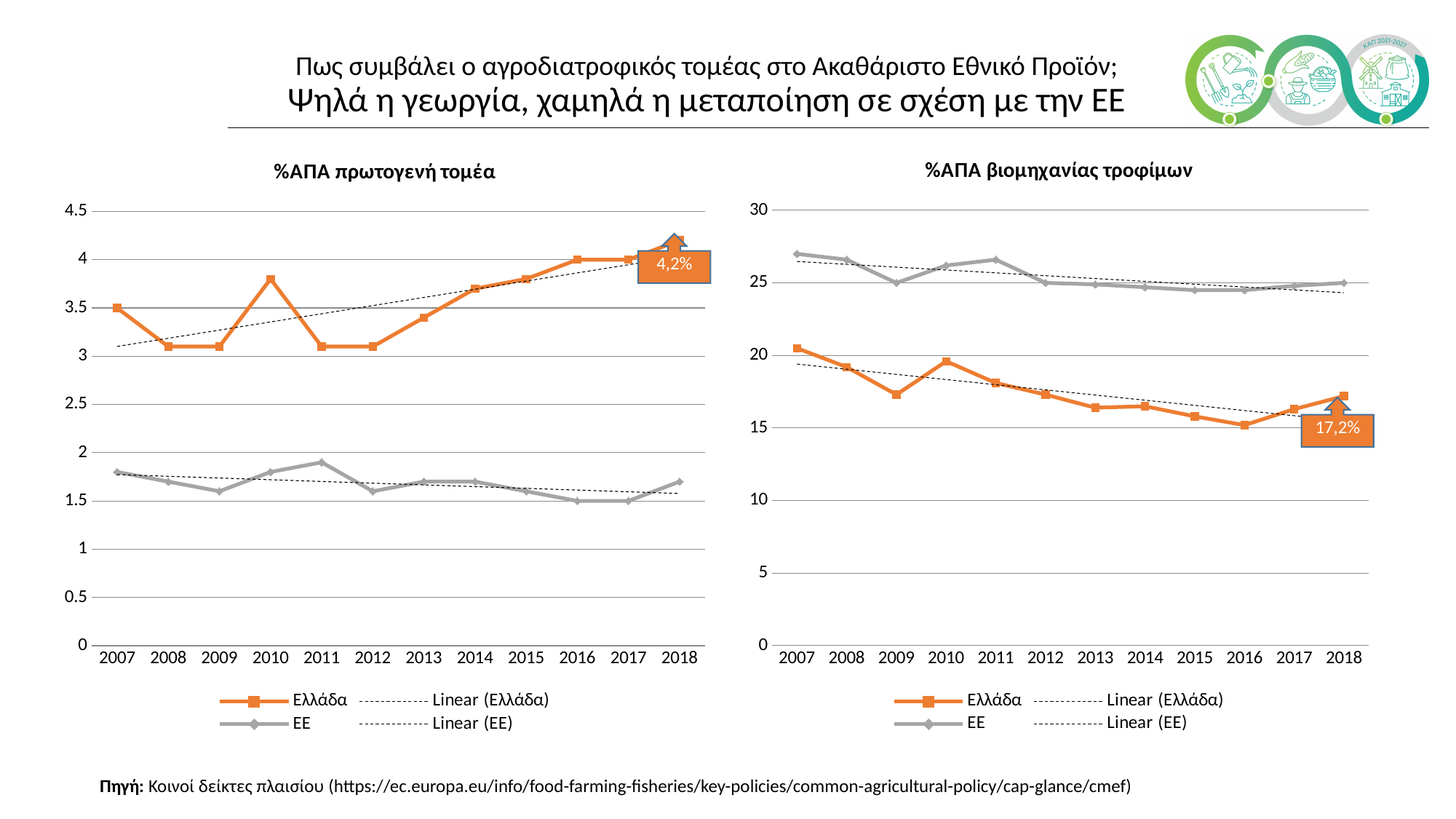
In the right chart '%ΑΠΑ βιομηχανίας τροφίμων', is the value for ΕΕ in 2007 greater or less than 25? greater How many years are shown on the x axis of the left chart '%ΑΠΑ πρωτογενή τομέα'? 12 In the left chart '%ΑΠΑ πρωτογενή τομέα', in which year is the Ελλάδα value highest? 2018 In the right chart '%ΑΠΑ βιομηχανίας τροφίμων', does the Ελλάδα line overall rise or fall from 2007 to 2018? fall In the right chart '%ΑΠΑ βιομηχανίας τροφίμων', what value is labelled for Ελλάδα in 2018? 17,2% In the left chart '%ΑΠΑ πρωτογενή τομέα', what value is labelled for Ελλάδα in 2018? 4,2% How many entries does the legend of the right chart '%ΑΠΑ βιομηχανίας τροφίμων' list? 4 What kind of chart is the left chart, '%ΑΠΑ πρωτογενή τομέα'? line chart In the left chart '%ΑΠΑ πρωτογενή τομέα', is the value for ΕΕ in 2016 greater or less than 2? less In the right chart '%ΑΠΑ βιομηχανίας τροφίμων', which is higher in 2007, Ελλάδα or ΕΕ? ΕΕ In the right chart '%ΑΠΑ βιομηχανίας τροφίμων', in which year is the Ελλάδα value lowest? 2016 In the left chart '%ΑΠΑ πρωτογενή τομέα', which is higher in 2018, Ελλάδα or ΕΕ? Ελλάδα